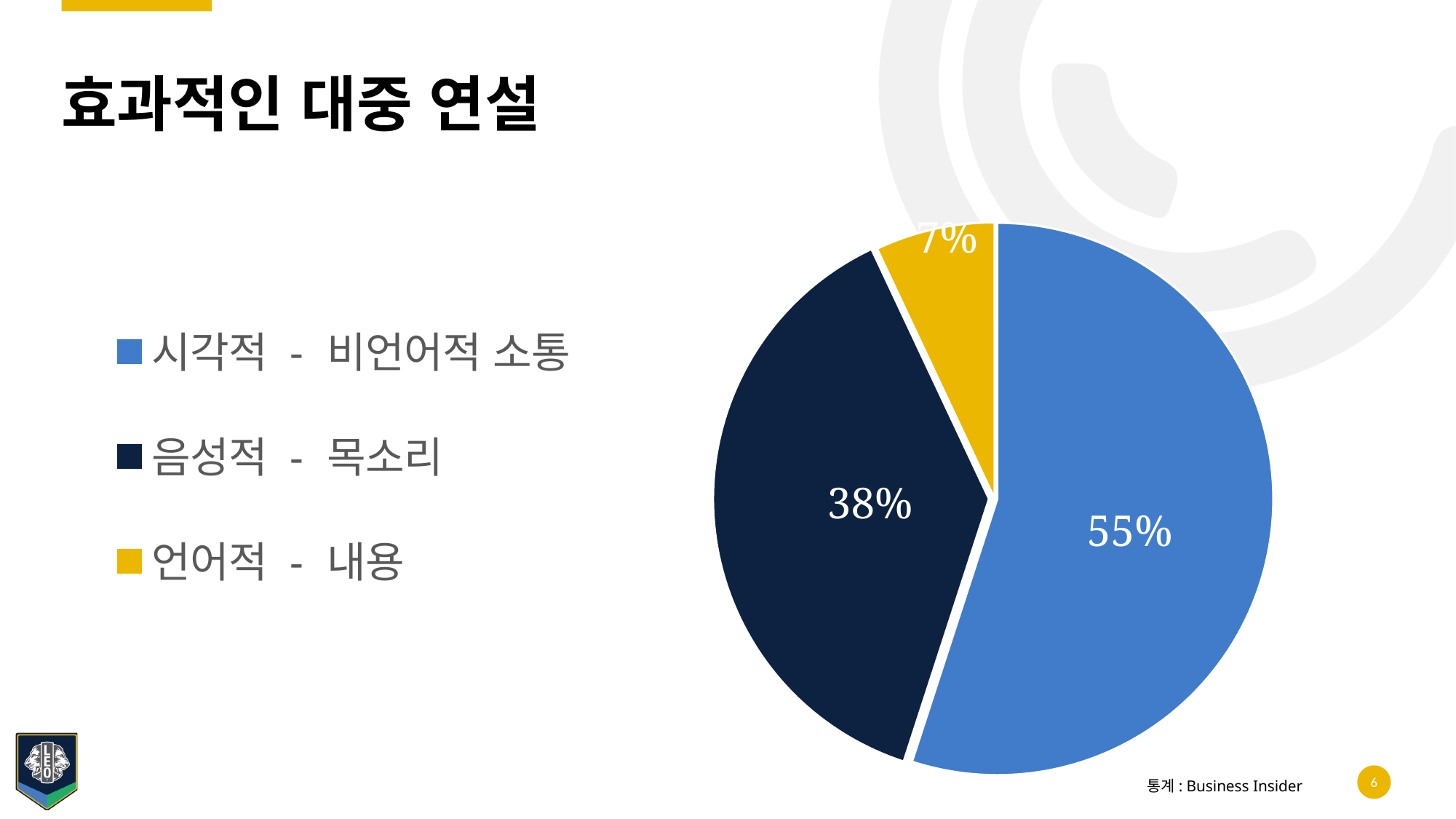
Which is larger, the 음성적 - 목소리 slice or the 언어적 - 내용 slice? 음성적 - 목소리 What percentage is shown for 음성적 - 목소리? 38% How many slices does the pie chart have? 3 What is the combined share of 음성적 - 목소리 and 언어적 - 내용? 45% What is the difference between the 시각적 - 비언어적 소통 slice and the 음성적 - 목소리 slice? 17% Which category has the largest slice of the pie? 시각적 - 비언어적 소통 What percentage is shown for 언어적 - 내용? 7% How many entries does the legend list? 3 What percentage is shown for 시각적 - 비언어적 소통? 55% What kind of chart is shown on the slide? pie chart What colour is the slice for 언어적 - 내용? yellow Which category has the smallest slice of the pie? 언어적 - 내용